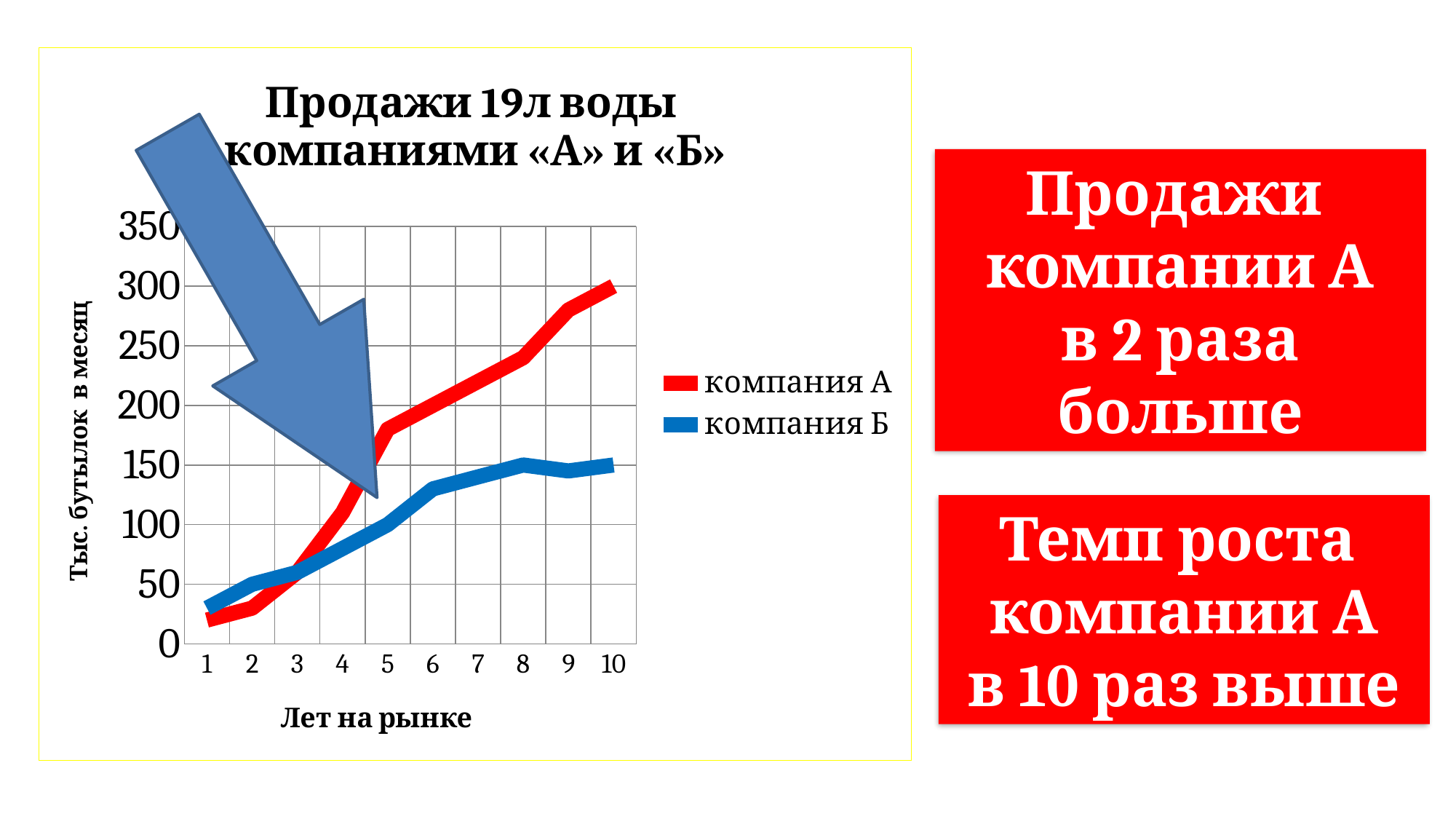
Is the value for компания Б at year 1 greater or less than 50? less At year 10, which company has higher sales, компания А or компания Б? компания А Is the value for компания Б at year 10 greater or less than 200? less How many years are shown on the x axis of the chart? 10 What kind of chart is shown on the slide? line chart Do the sales of компания А rise or fall as the years on the market increase? rise At year 2, which company has higher sales, компания А or компания Б? компания Б What is the title of the chart? Продажи 19л воды компаниями «А» и «Б» Is the value for компания А at year 10 greater or less than 250? greater What colour is the line for компания Б? blue How many series does the legend list? 2